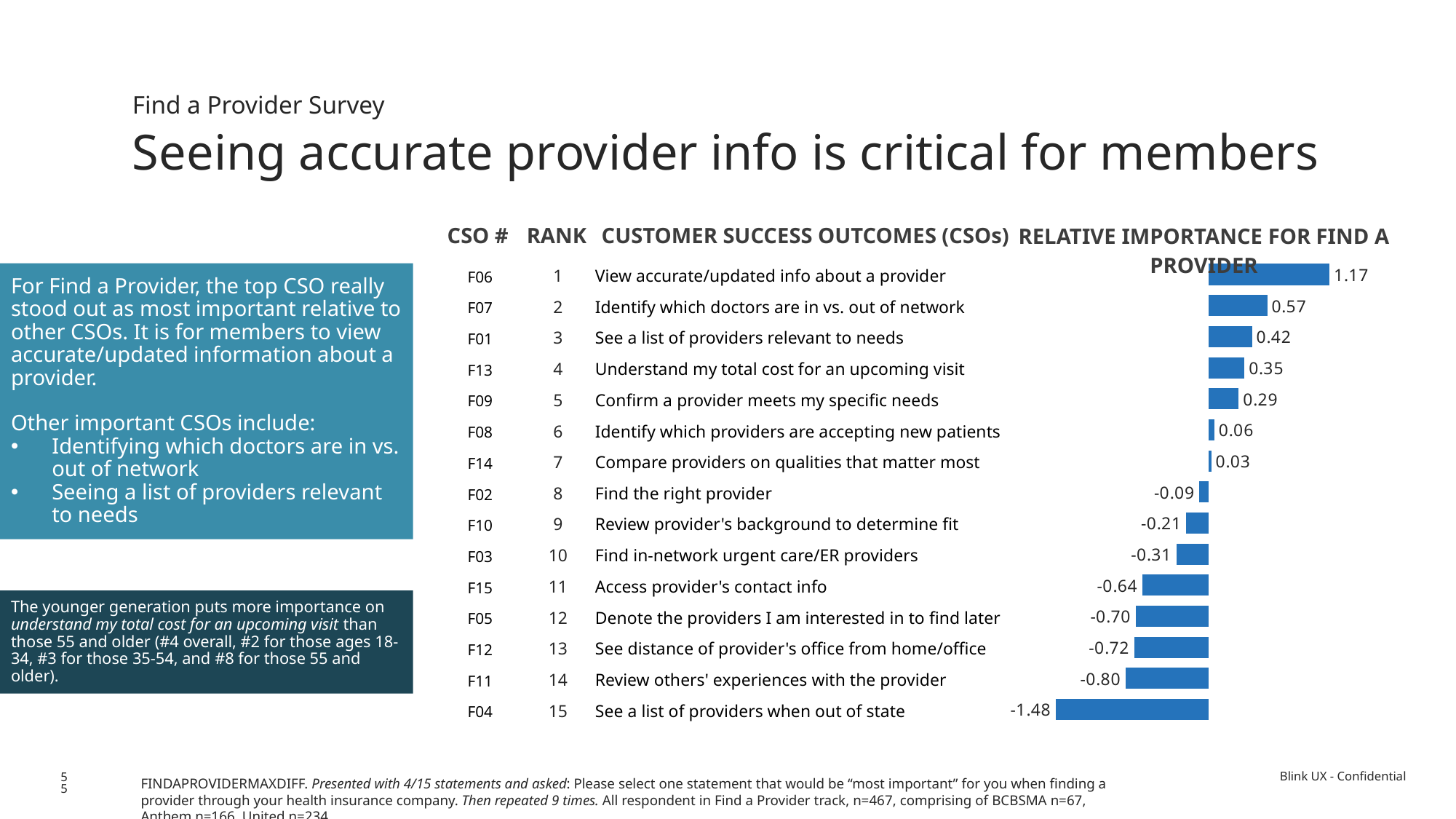
How many CSOs have a negative relative importance value? 8 What is the relative importance value for 'View accurate/updated info about a provider' (F06)? 1.17 What is the title of the chart column showing the bar values? Relative Importance for Find a Provider What is the relative importance value for 'Review others' experiences with the provider' (F11)? -0.80 What is the relative importance value for 'Understand my total cost for an upcoming visit' (F13)? 0.35 What is the difference between the relative importance of F06 (1.17) and F07 (0.57)? 0.60 Which CSO has the lowest relative importance for Find a Provider? See a list of providers when out of state How many CSOs are plotted in the relative importance chart? 15 Which CSO has the highest relative importance for Find a Provider? View accurate/updated info about a provider Which has a higher relative importance: 'Identify which doctors are in vs. out of network' or 'See a list of providers relevant to needs'? Identify which doctors are in vs. out of network What kind of chart shows the relative importance for Find a Provider? Bar chart What is the relative importance value for 'Find in-network urgent care/ER providers' (F03)? -0.31